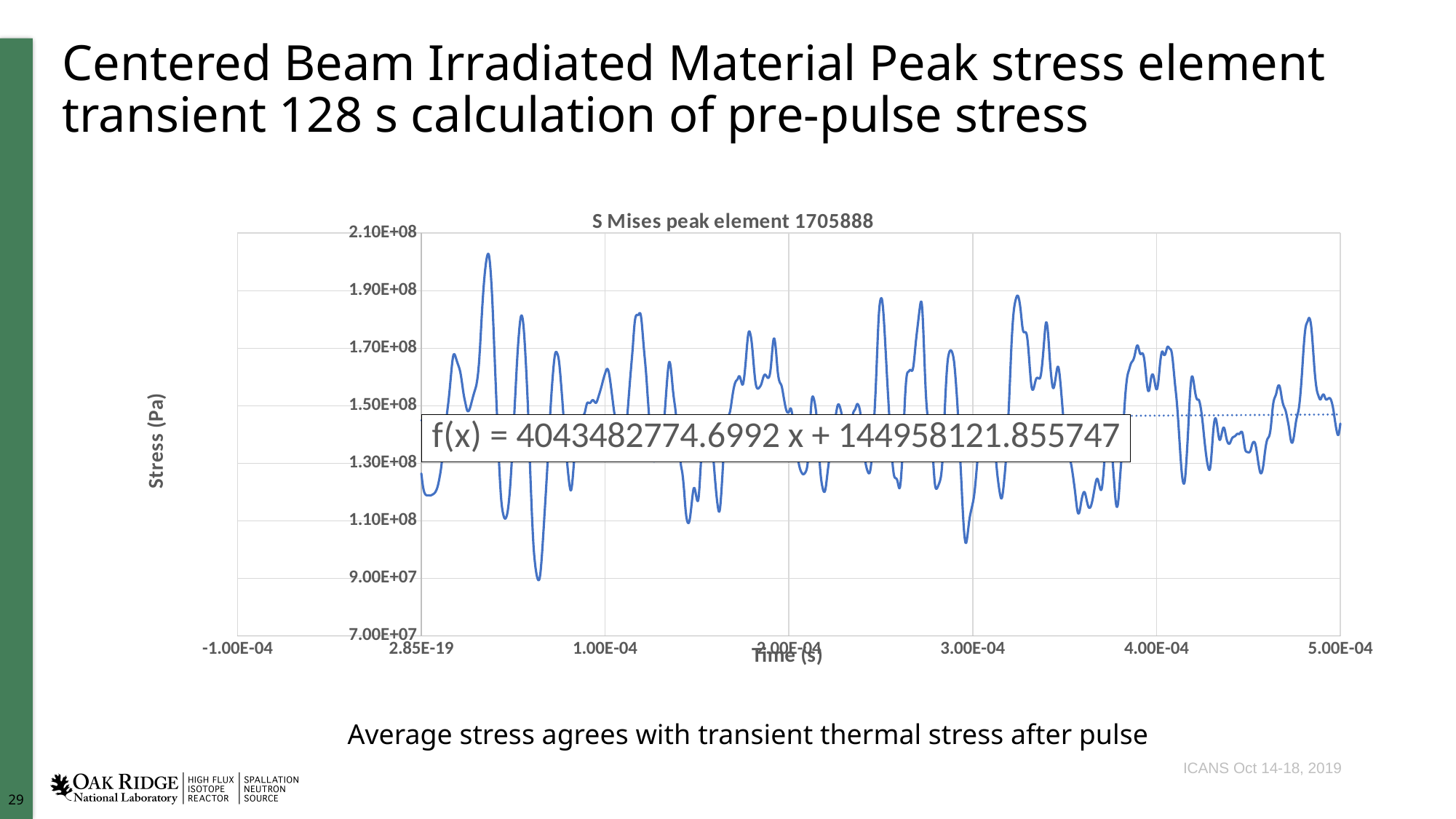
How many data series are plotted as solid lines on the chart? 1 What is the label of the vertical axis of the chart? Stress (Pa) What kind of chart is shown on the slide? line chart What is the title of the chart? S Mises peak element 1705888 Is the highest peak of the stress line greater or less than 1.90E+08? greater Is the lowest point of the stress line greater or less than 1.10E+08? less What is the highest value shown on the vertical axis of the chart? 2.10E+08 What is the intercept of the trendline equation shown on the chart? 144958121.855747 What is the largest time value shown on the horizontal axis of the chart? 5.00E-04 Is the stress value at time 5.00E-04 greater or less than 1.50E+08? less According to the trendline equation, is the slope of the fitted line positive or negative? positive What is the trendline equation displayed on the chart? f(x) = 4043482774.6992 x + 144958121.855747